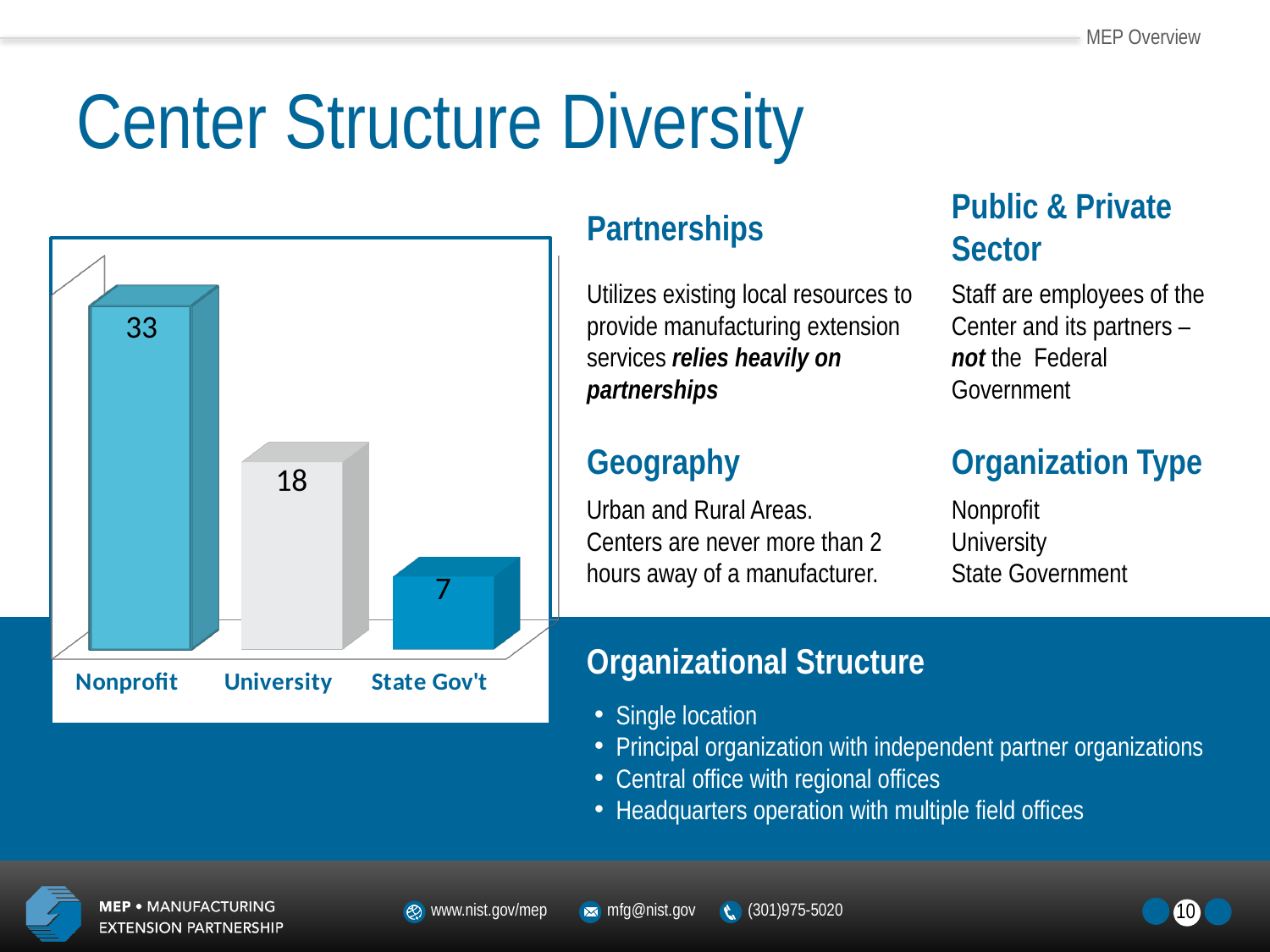
What is the value for University in the chart? 18 Do the values rise or fall from left to right across the categories? Fall Which category has the highest value in the chart? Nonprofit What is the value for Nonprofit in the chart? 33 What is the difference between the values for University and State Gov't? 11 What kind of chart is shown on the slide? Bar chart What is the value for State Gov't in the chart? 7 What is the total of the three values shown in the chart? 58 Which is larger, the value for University or the value for State Gov't? University How many categories are shown in the chart? 3 Which category has the lowest value in the chart? State Gov't What is the difference between the values for Nonprofit and University? 15